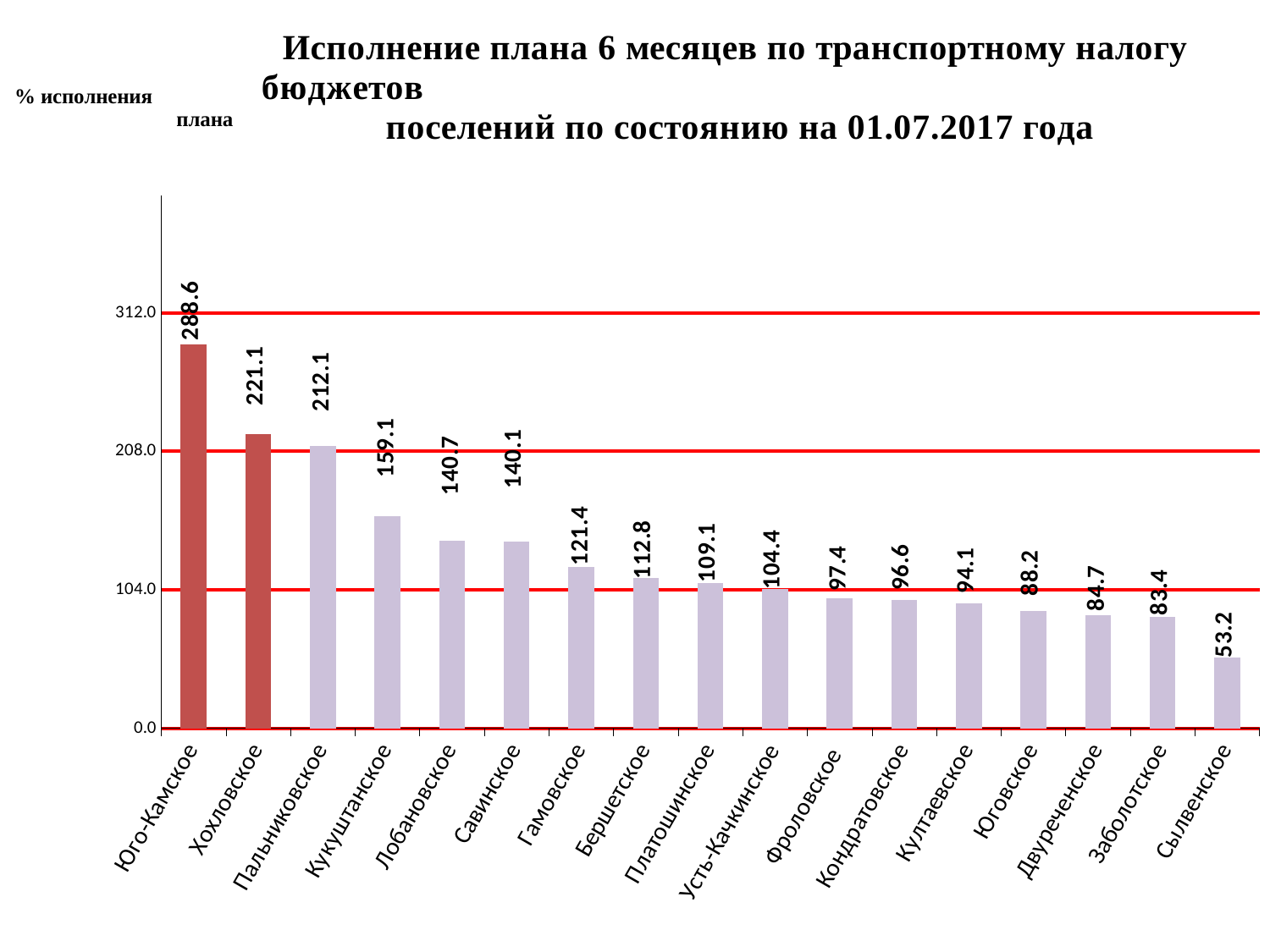
Which category has the lowest value? Сылвенское What is the value for Сылвенское? 53.2 What type of chart is shown on the slide? bar chart Is the value for Усть-Качкинское greater or less than 104.0? greater What is the difference between the values for Хохловское and Пальниковское? 9.0 What is the value for Юго-Камское? 288.6 How many bars are coloured red rather than lilac? 2 How many categories are shown on the x axis? 17 Do the values rise or fall from left to right along the x axis? fall Which category has the highest value? Юго-Камское What is the value for Кукуштанское? 159.1 Which is larger, the value for Гамовское or the value for Бершетское? Гамовское